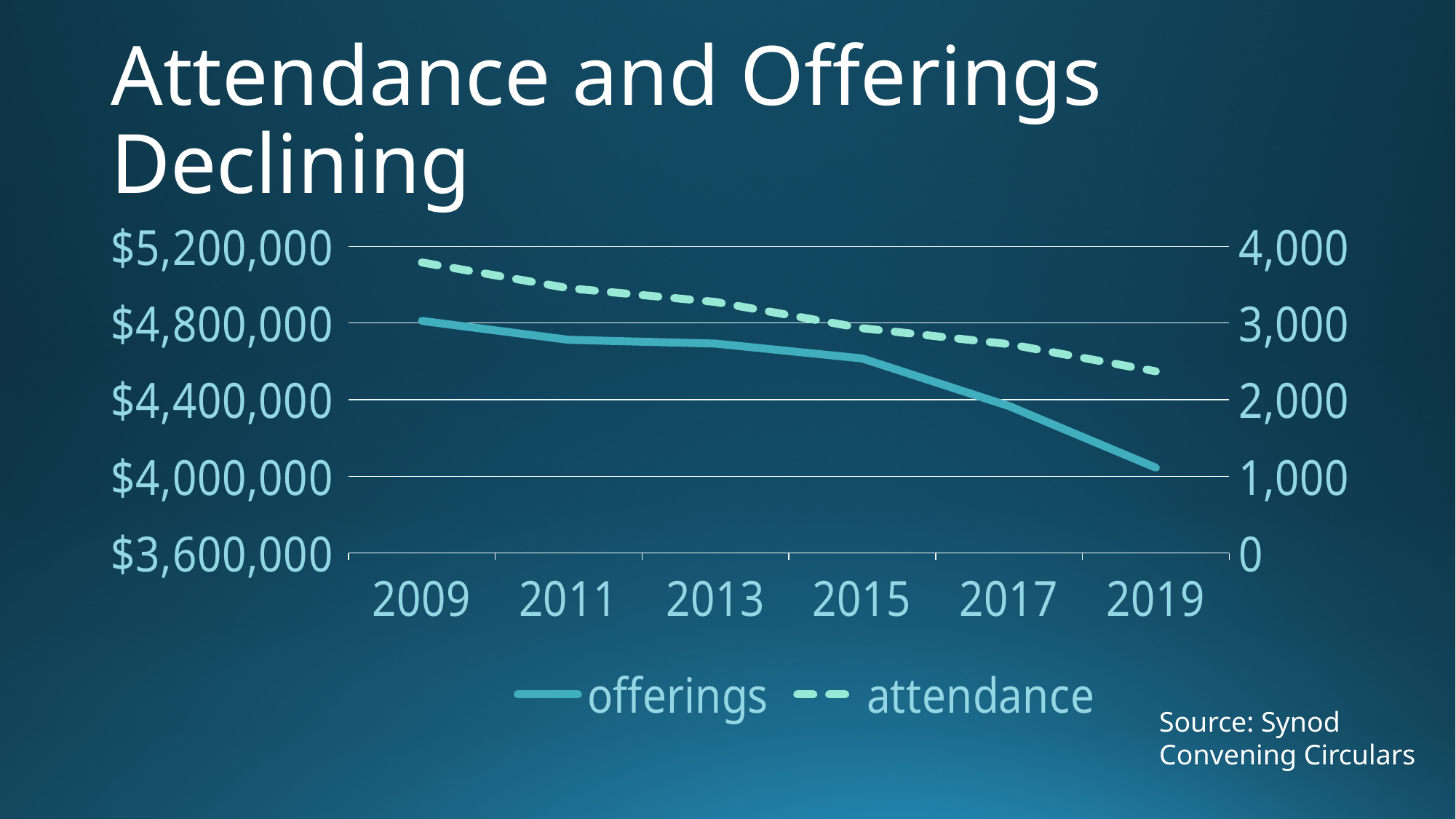
How many series does the legend list? 2 Does attendance rise or fall from 2009 to 2019? fall Is the value for attendance in 2019 greater or less than 3,000? less What is the title of the slide? Attendance and Offerings Declining Do offerings rise or fall from 2009 to 2019? fall How many years are labelled on the x axis? 6 Is the value for offerings in 2009 greater or less than $4,400,000? greater Is the value for offerings in 2019 greater or less than $4,400,000? less Which series is drawn with a dashed line? attendance What kind of chart is shown on the slide? line chart